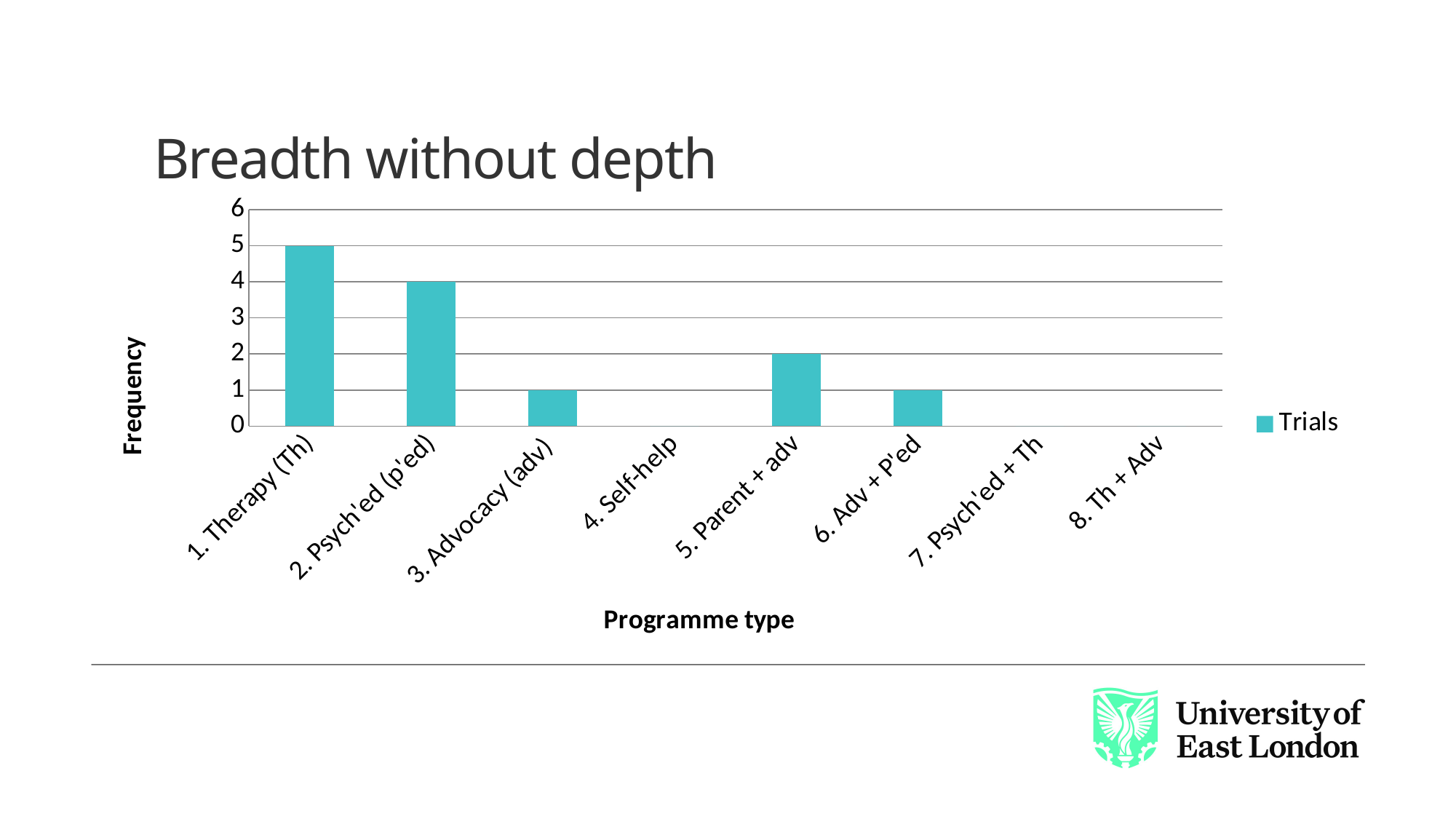
How many programme types are shown on the x axis? 8 How many series does the legend list? 1 What type of chart is shown on the slide? Bar chart What is the frequency for 1. Therapy (Th)? 5 What is the frequency for 3. Advocacy (adv)? 1 Which programme type has the highest frequency? 1. Therapy (Th) What is the title of the slide? Breadth without depth What is the frequency for 5. Parent + adv? 2 What is the frequency for 2. Psych'ed (p'ed)? 4 Which has a higher frequency, 5. Parent + adv or 6. Adv + P'ed? 5. Parent + adv What is the difference in frequency between 1. Therapy (Th) and 2. Psych'ed (p'ed)? 1 What is the label of the y axis? Frequency